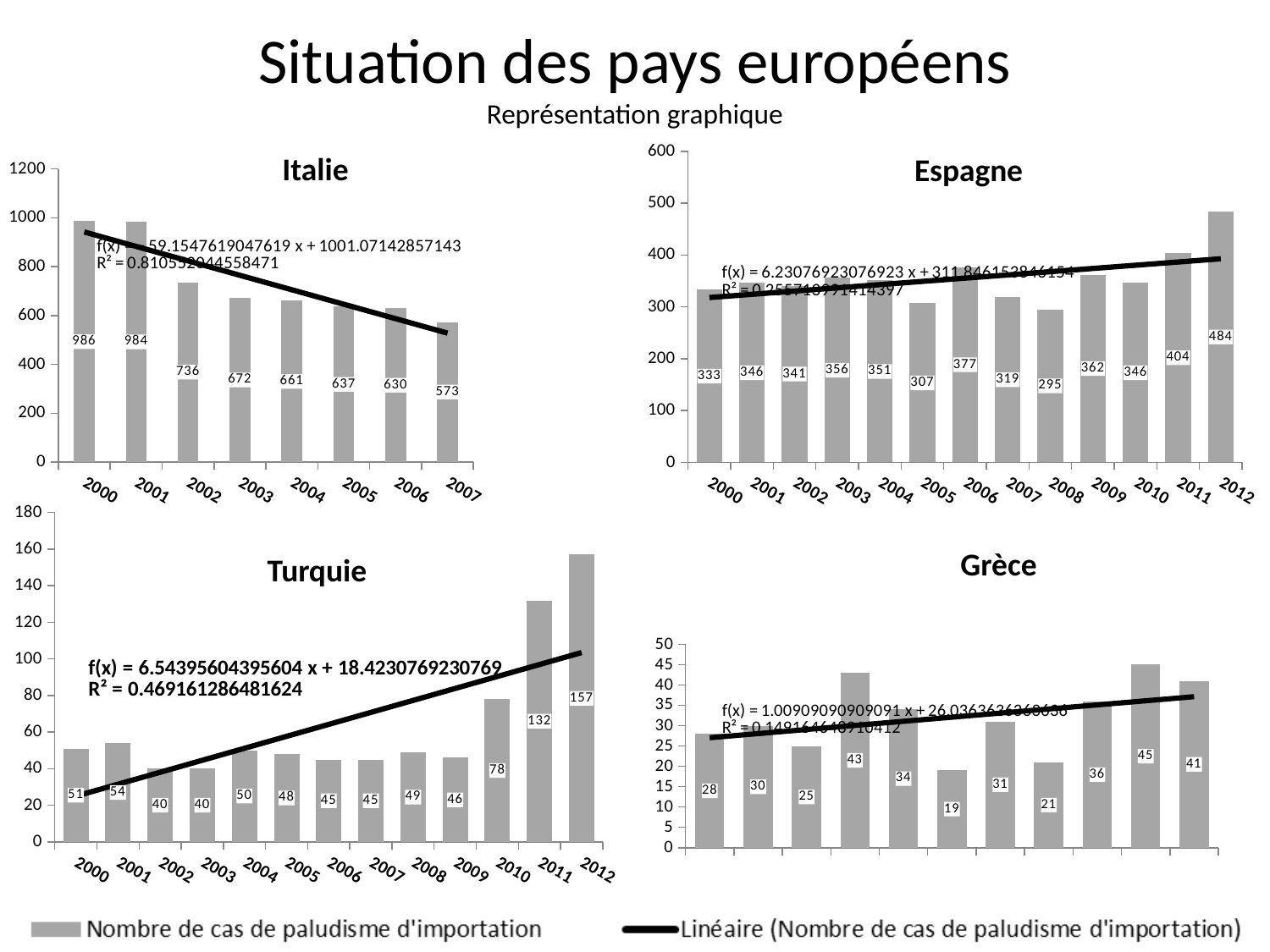
In the Italie chart, what is the value for 2002? 736 In the Italie chart, which year has the lowest value? 2007 In the Espagne chart, which year has the lowest value? 2008 In the Espagne chart, which is larger, the value for 2009 or the value for 2010? 2009 In the Italie chart, do the values generally rise or fall from 2000 to 2007? fall What kind of chart is the Turquie chart? bar chart In the Espagne chart, which year has the highest value? 2012 How many years are shown in the Turquie chart? 13 In the Grèce chart, what is the highest value shown on a bar? 45 In the Turquie chart, what is the value for 2011? 132 In the Espagne chart, what is the value for 2006? 377 In the Italie chart, what is the difference between the values for 2000 and 2007? 413